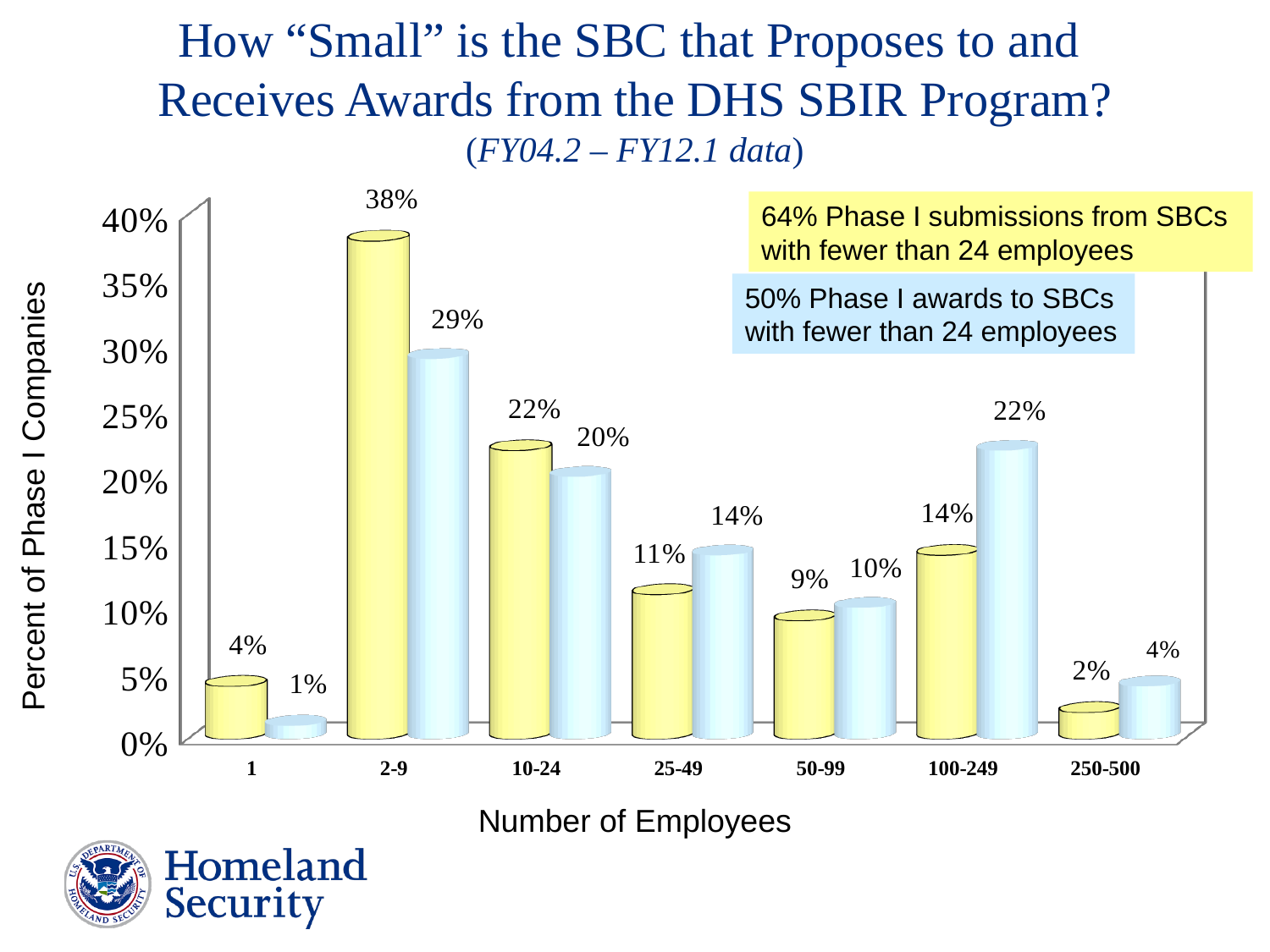
What is the label of the x axis? Number of Employees For the 100-249 employees category, which bar is larger, the yellow or the blue? blue How many employee-count categories are shown on the x axis? 7 What is the difference between the blue bars for 100-249 employees and 250-500 employees? 18% What is the label of the y axis? Percent of Phase I Companies What type of chart is shown on the slide? bar chart What is the value of the blue bar for the 100-249 employees category? 22% What is the value of the yellow bar for the 2-9 employees category? 38% Which employee-count category has the highest yellow bar? 2-9 What is the value of the blue bar for the 1 employee category? 1% What is the difference between the yellow and blue bars for the 2-9 employees category? 9% Which employee-count category has the lowest blue bar? 1